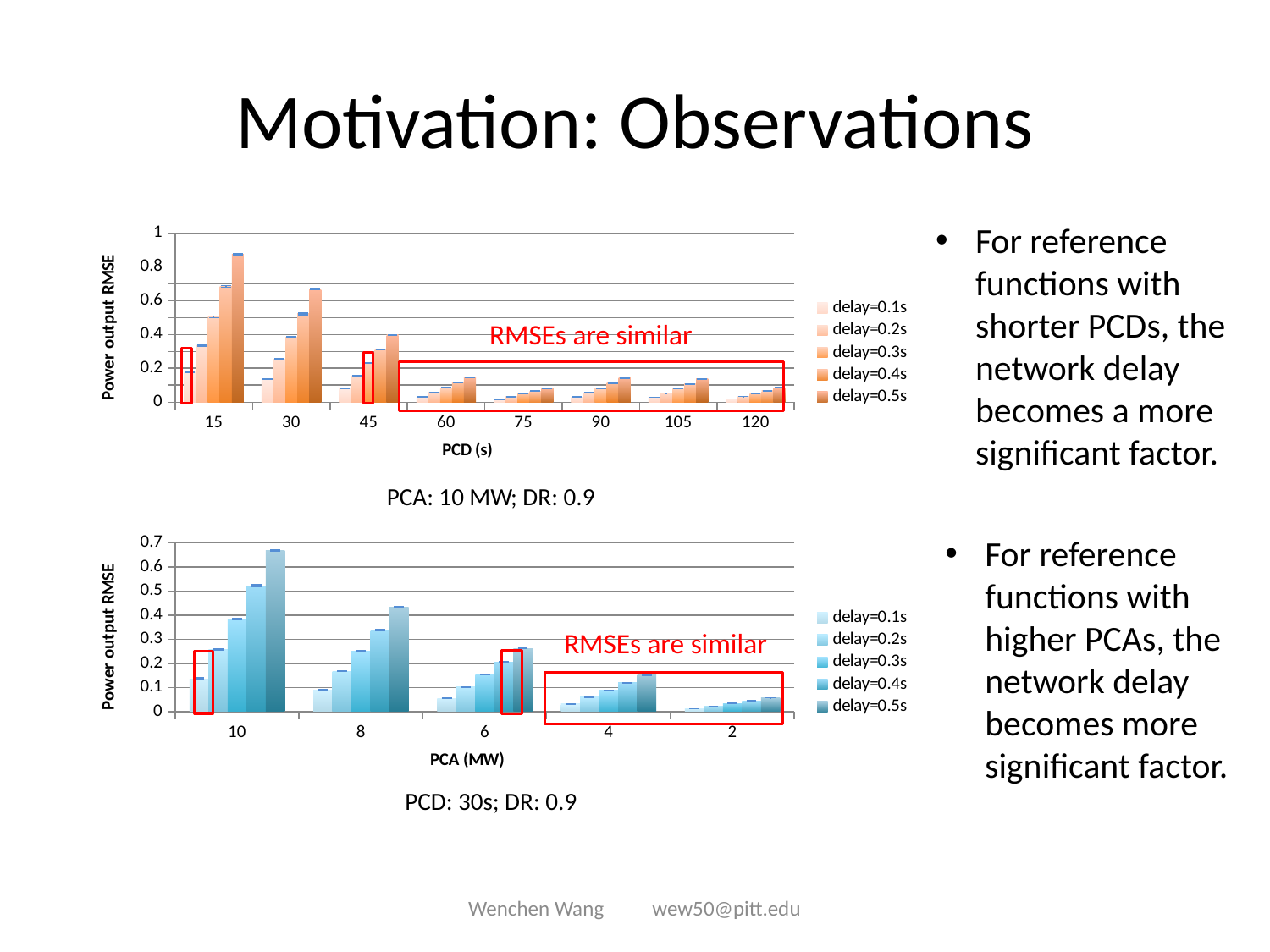
How many PCD categories are shown on the x axis of the top chart? 8 In the bottom chart, which is larger for delay=0.5s: the value at PCA 8 or at PCA 6? PCA 8 In the bottom chart, is the value for delay=0.5s at PCA 10 greater or less than 0.6? greater In the top chart, at which PCD is the delay=0.5s bar highest? 15 In the top chart, do the delay=0.5s values rise or fall as PCD increases from 15 to 120? fall What kind of chart is the top chart (PCD on the x axis)? bar chart In the top chart, is the value for delay=0.5s at PCD 120 greater or less than 0.2? less In the top chart, which is larger for delay=0.5s: the value at PCD 15 or at PCD 30? PCD 15 How many series does the legend of the top chart list? 5 In the top chart, is the value for delay=0.5s at PCD 15 greater or less than 0.8? greater What is the y-axis title of the bottom chart? Power output RMSE How many PCA categories are shown on the x axis of the bottom chart? 5